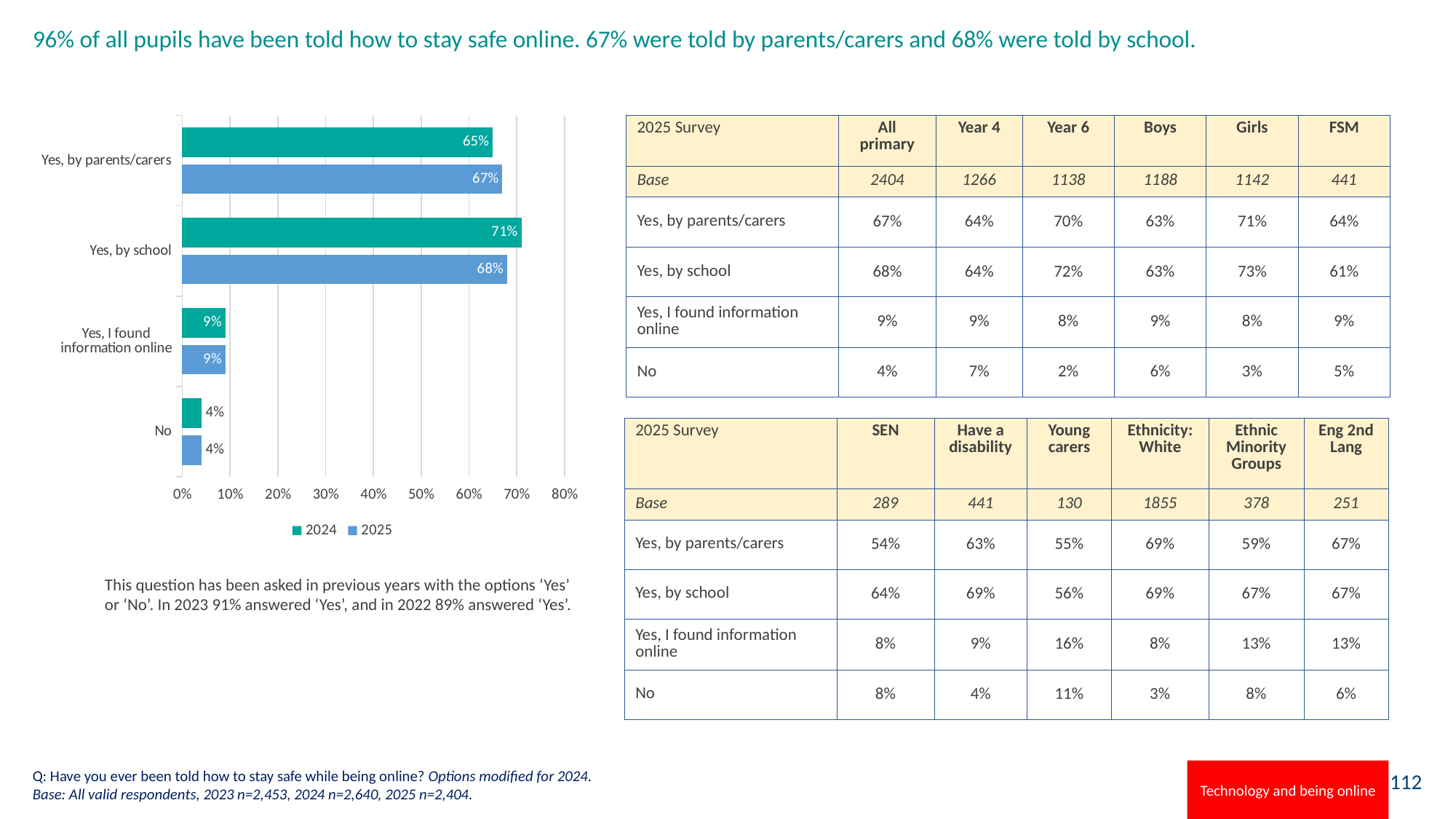
How many series does the legend of the bar chart list? 2 What is the 2025 value for 'Yes, I found information online' in the bar chart? 9% What kind of chart is shown on the slide? bar chart How many categories are shown in the bar chart? 4 Which category has the lowest 2024 value in the bar chart? No What is the difference between the 2024 and 2025 values for 'Yes, by school' in the bar chart? 3% In the bar chart, is the 2024 value for 'Yes, by parents/carers' larger or smaller than the 2025 value? smaller What is the 2025 value for 'Yes, by parents/carers' in the bar chart? 67% Which category has the highest 2025 value in the bar chart? Yes, by school What is the 2024 value for 'Yes, by school' in the bar chart? 71% Which series is shown in green in the bar chart? 2024 What is the 2024 value for 'No' in the bar chart? 4%